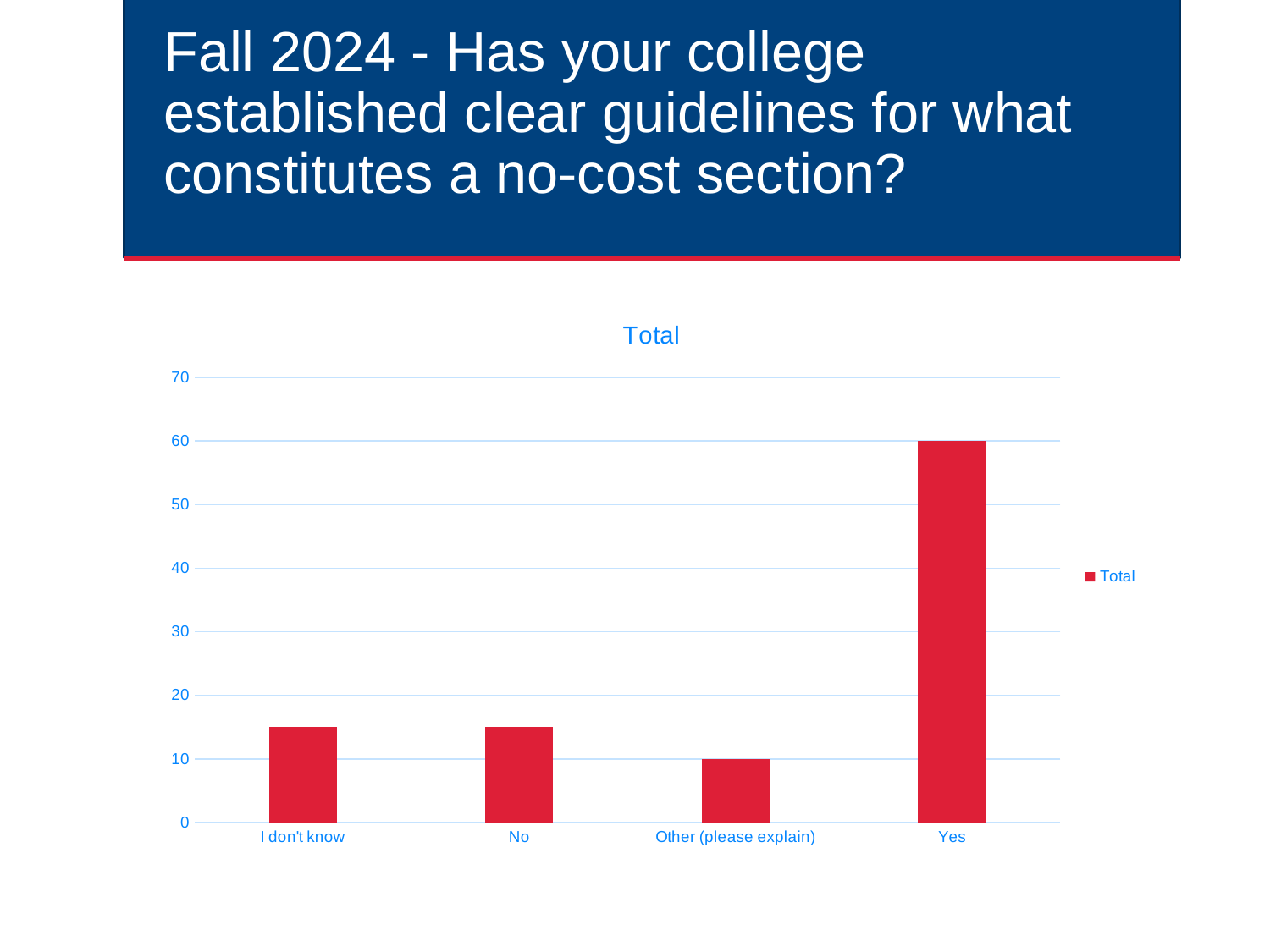
What is the value for Other (please explain)? 10 Which category has the lowest value? Other (please explain) Which category has the highest value? Yes What is the title of the chart? Total What is the difference between the values for Yes and Other (please explain)? 50 Is the value for No greater or less than 10? greater Is the value for I don't know greater or less than 20? less Which is larger, the value for Yes or the value for No? Yes How many categories are shown on the x axis? 4 How many series does the legend list? 1 What kind of chart is shown on the slide? Bar chart What is the value for Yes? 60